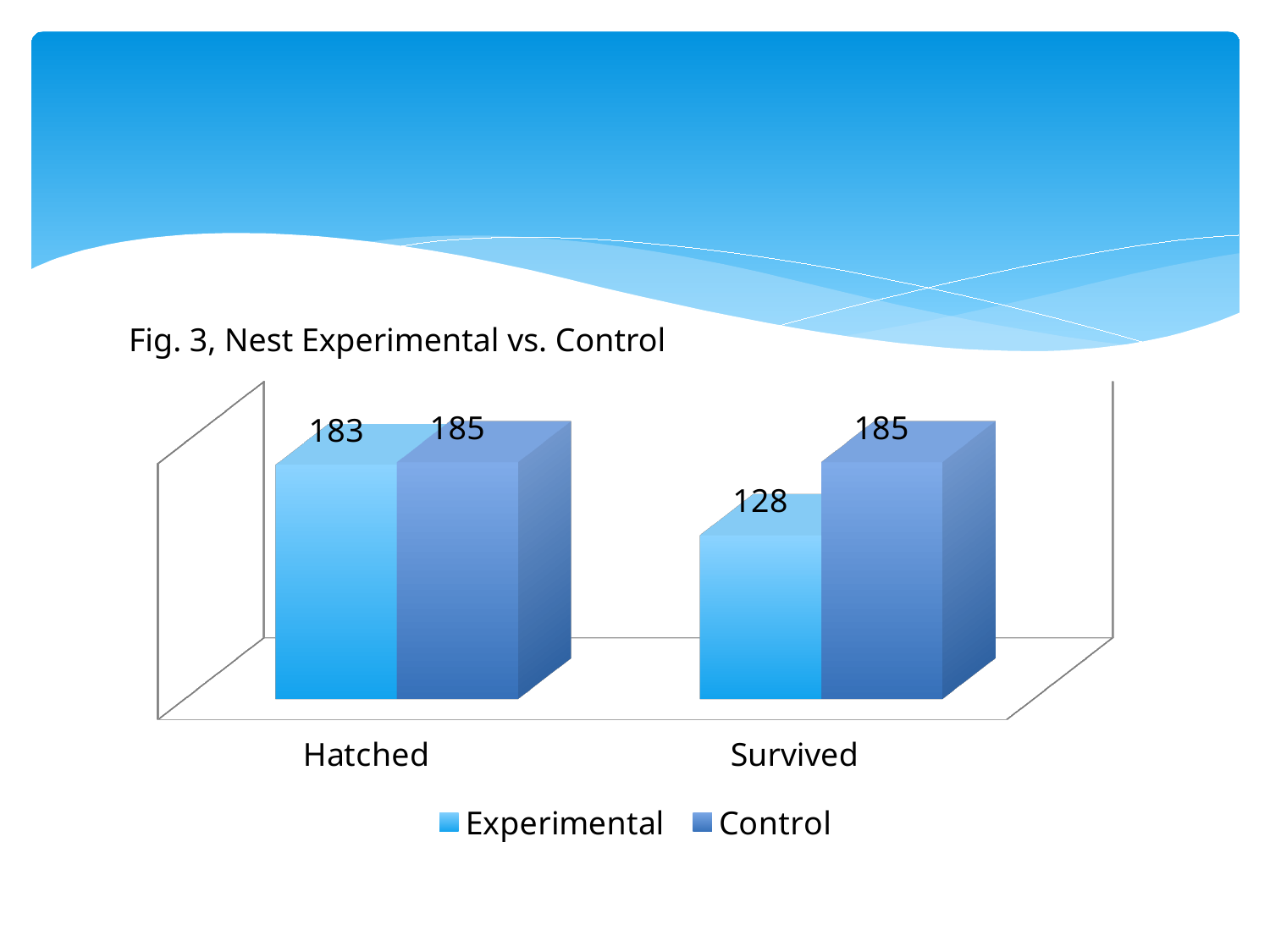
What is the Experimental value for Survived? 128 What is the difference between the Experimental values for Hatched and Survived? 55 What is the title of the chart? Fig. 3, Nest Experimental vs. Control What is the Control value for Survived? 185 What is the Control value for Hatched? 185 Which is larger for Survived, the Experimental value or the Control value? Control How many series does the legend list? 2 How many categories are shown on the x axis? 2 Which category has the lowest Experimental value? Survived What kind of chart is shown on the slide? Bar chart What is the difference between the Control and Experimental values for Survived? 57 What is the Experimental value for Hatched? 183